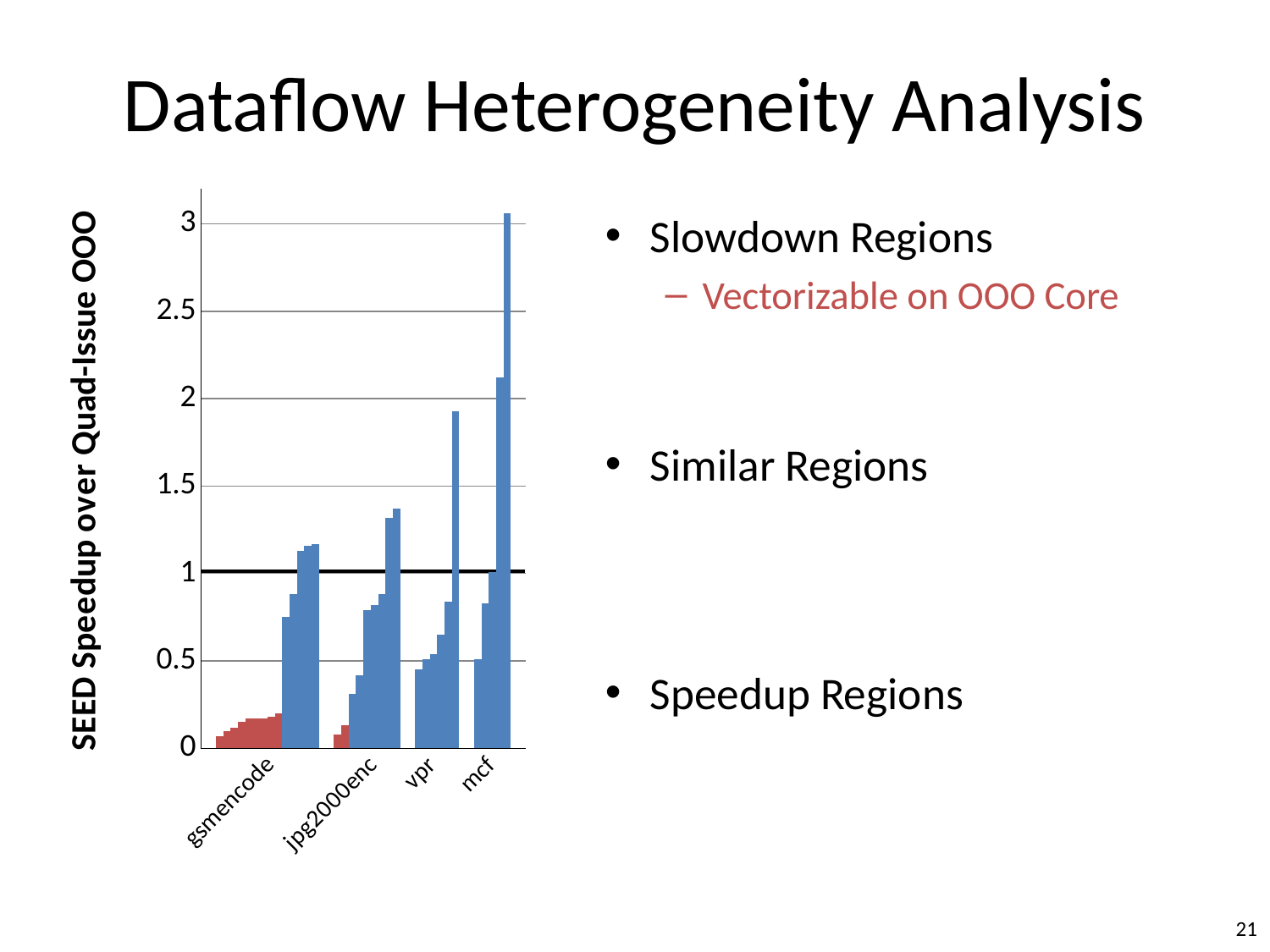
Is the tallest bar for mcf greater or less than 2.5? greater Are the red bars for gsmencode greater or less than 0.5? less At what y-axis value is the thick horizontal reference line drawn in the chart? 1 Which benchmark has a taller maximum bar, vpr or jpg2000enc? vpr What kind of chart is shown on the slide? bar chart Which benchmark has a taller maximum bar, gsmencode or mcf? mcf Which benchmark contains the tallest bar in the chart? mcf What is the highest tick value shown on the y axis of the chart? 3 Is the tallest bar for vpr greater or less than 2? less How many benchmark labels appear on the x axis of the chart? 4 What is the title of the y axis of the chart? SEED Speedup over Quad-Issue OOO